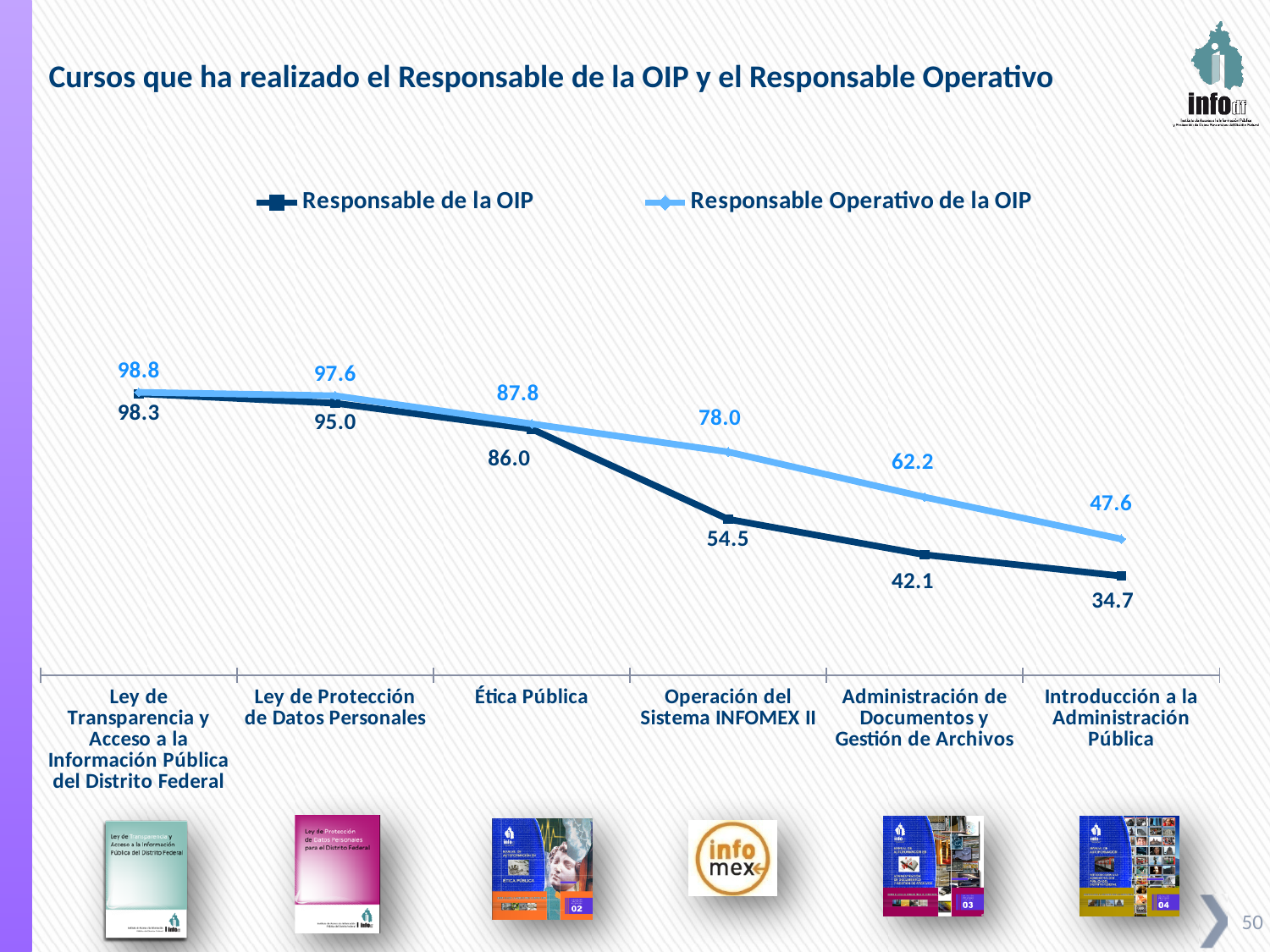
For Administración de Documentos y Gestión de Archivos, which series has the larger value? Responsable Operativo de la OIP Do the values for Responsable de la OIP rise or fall from left to right along the x axis? Fall Which course has the lowest value for Responsable de la OIP? Introducción a la Administración Pública How many series does the legend list? 2 What is the value for Responsable de la OIP for Introducción a la Administración Pública? 34.7 What is the value for Responsable de la OIP for Ética Pública? 86.0 How many course categories are shown on the x axis? 6 What kind of chart is shown on the slide? Line chart Which course has the highest value for Responsable Operativo de la OIP? Ley de Transparencia y Acceso a la Información Pública del Distrito Federal What is the value for Responsable Operativo de la OIP for Operación del Sistema INFOMEX II? 78.0 What is the difference between Responsable Operativo de la OIP and Responsable de la OIP for Operación del Sistema INFOMEX II? 23.5 What is the title of the chart? Cursos que ha realizado el Responsable de la OIP y el Responsable Operativo